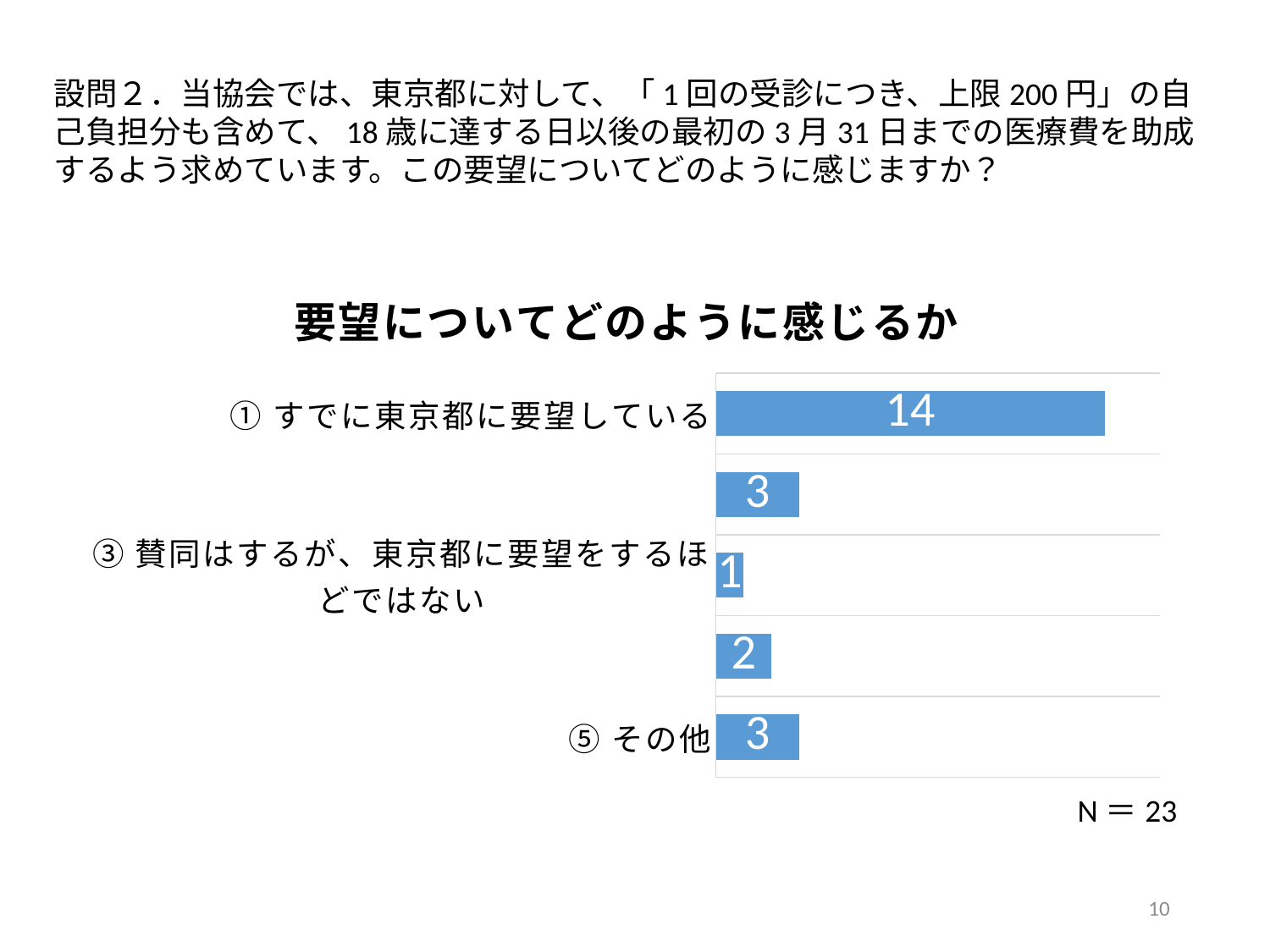
Which is larger, the value for ① すでに東京都に要望している or the value for ⑤ その他? ① すでに東京都に要望している Which category has the highest value? ① すでに東京都に要望している How many bars are plotted in the chart? 5 What is the difference between the values for ⑤ その他 and ③ 賛同はするが、東京都に要望をするほどではない? 2 What kind of chart is shown on the slide? bar chart What is the value of N shown below the chart? 23 What is the value for ③ 賛同はするが、東京都に要望をするほどではない? 1 What is the title of the chart? 要望についてどのように感じるか Which category has the lowest value? ③ 賛同はするが、東京都に要望をするほどではない What is the difference between the values for ① すでに東京都に要望している and ⑤ その他? 11 What is the value for ① すでに東京都に要望している? 14 What is the value for ⑤ その他? 3